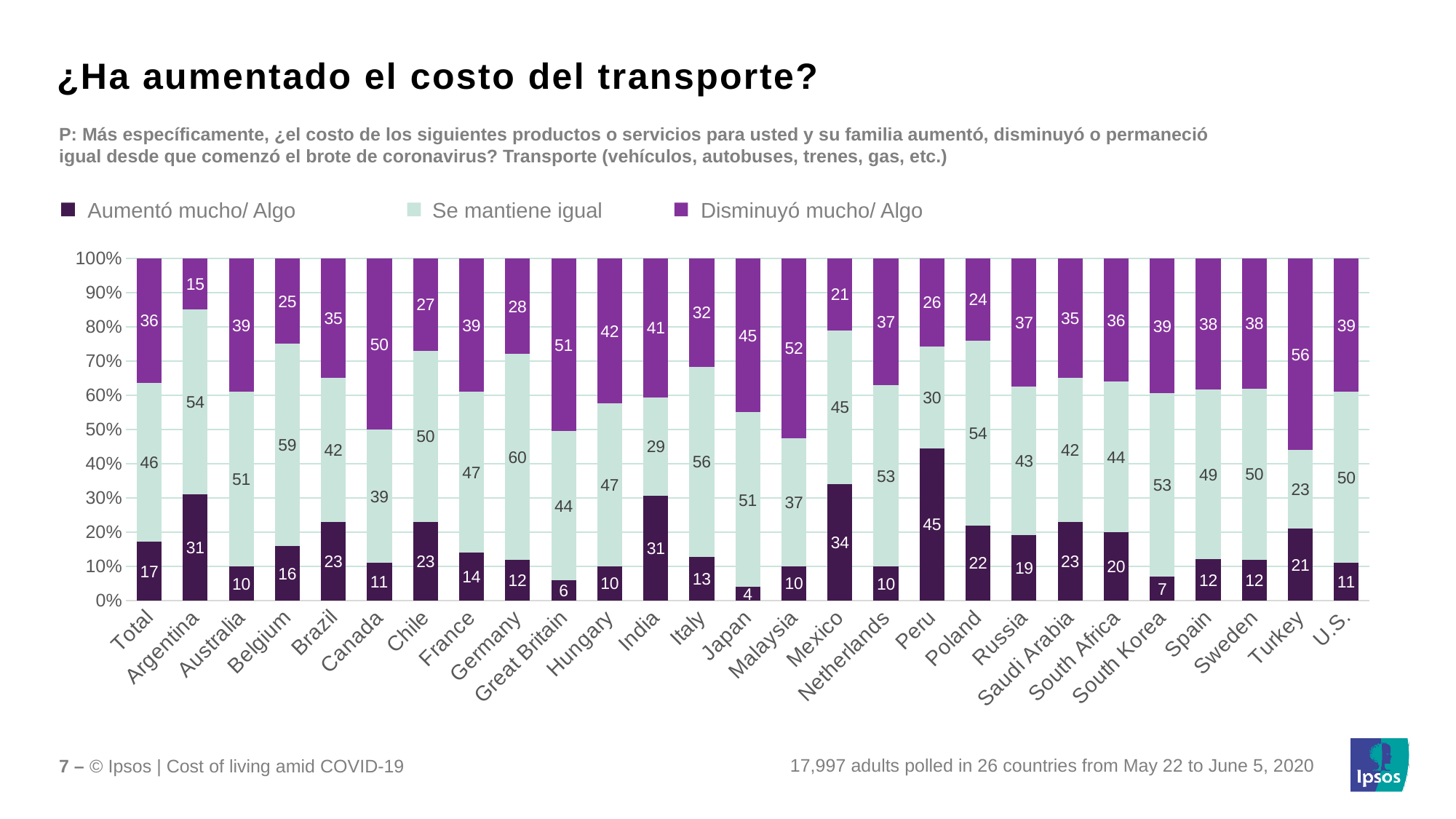
What is the difference between the 'Disminuyó mucho/ Algo' values for Turkey and Argentina? 41 Which country has the lowest 'Aumentó mucho/ Algo' value? Japan What kind of chart is shown on the slide? Stacked bar chart Which country has the lowest 'Disminuyó mucho/ Algo' value? Argentina What is the 'Se mantiene igual' value for Germany? 60 Which is larger: the 'Aumentó mucho/ Algo' value for Mexico or for India? Mexico What is the 'Disminuyó mucho/ Algo' value for Turkey? 56 How many series does the legend list? 3 What percentage of respondents in Peru said the cost of transport 'Aumentó mucho/ Algo'? 45 How many countries (excluding Total) are shown on the x axis? 26 What is the 'Aumentó mucho/ Algo' value for the Total bar? 17 Which country has the highest 'Aumentó mucho/ Algo' value? Peru